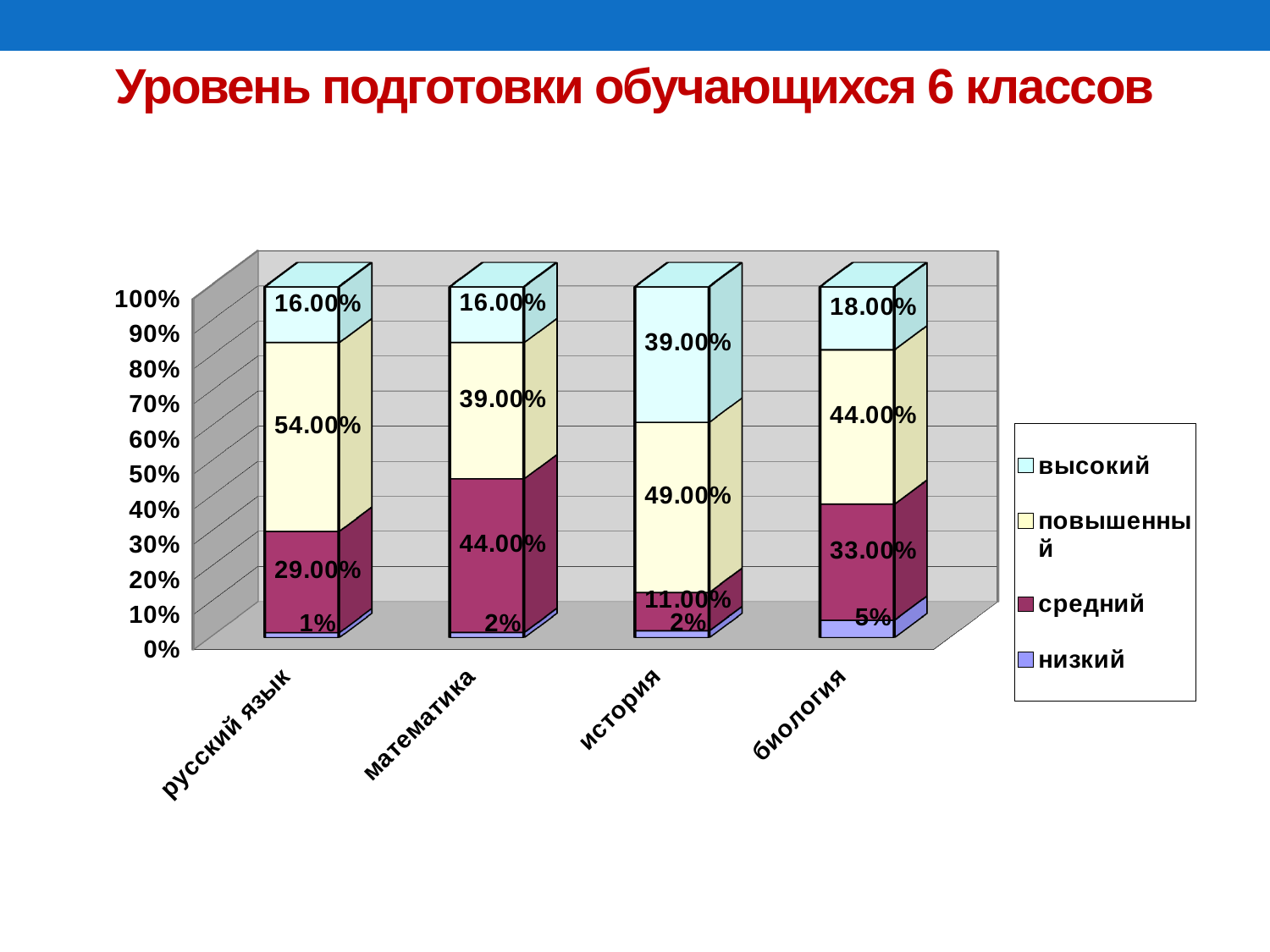
What is the difference between the повышенный values for русский язык and математика? 15.00% Which category has the lowest value for the средний series? история What is the title of the slide? Уровень подготовки обучающихся 6 классов What is the value of the низкий series for биология? 5% Which category has the highest value for the высокий series? история What is the value of the высокий series for история? 39.00% How many series does the legend list? 4 How many categories are shown on the x axis? 4 What is the value of the средний series for математика? 44.00% Which is larger: the средний value for биология or the средний value for русский язык? биология What kind of chart is shown on the slide? stacked bar chart What is the value of the повышенный series for русский язык? 54.00%